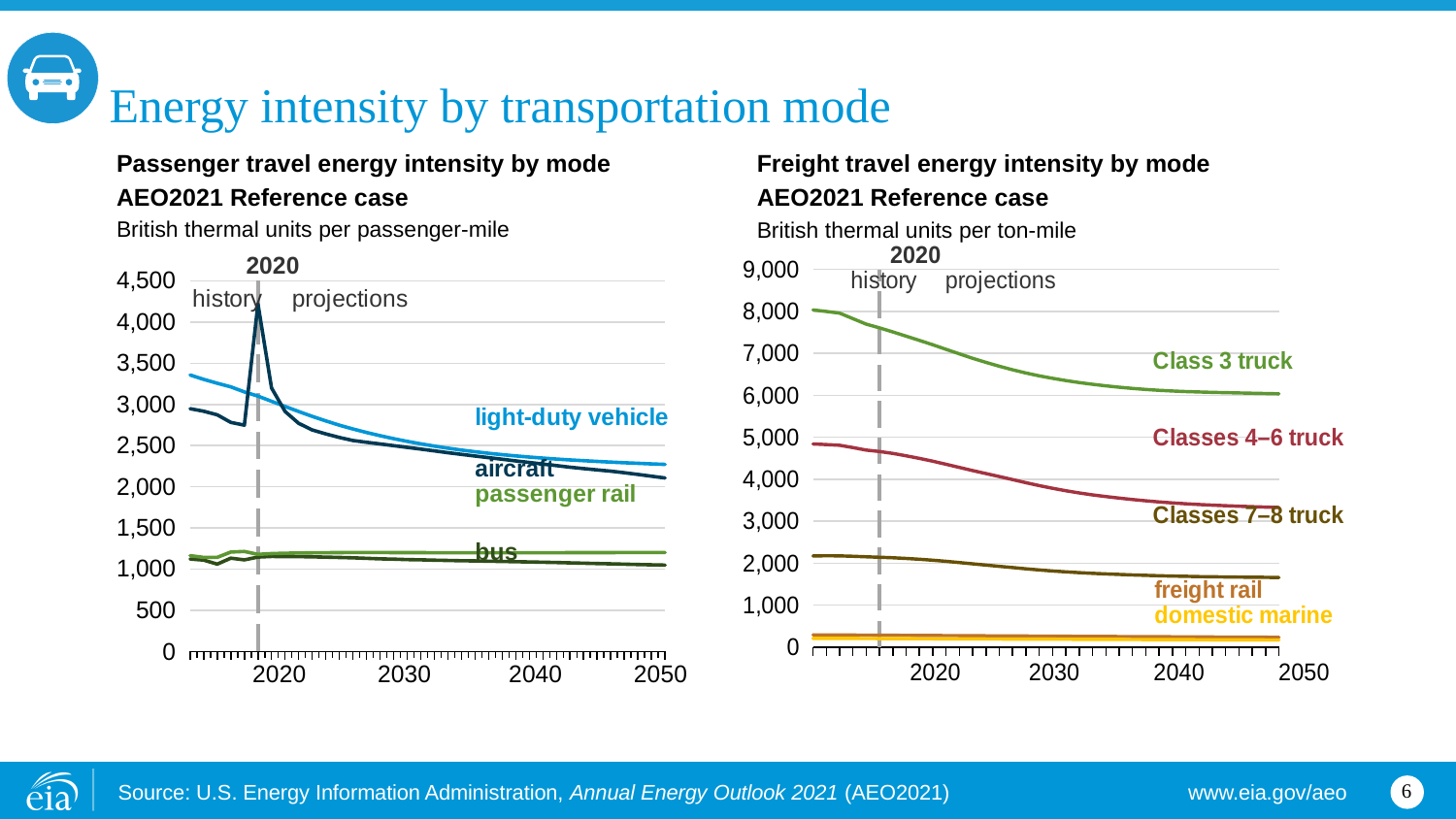
On the Passenger travel energy intensity by mode chart, is the peak value for aircraft greater or less than 4,000? greater On the Freight travel energy intensity by mode chart, does the energy intensity of Class 3 truck rise or fall from 2020 to 2050? fall On the Freight travel energy intensity by mode chart, is the value for Classes 7–8 truck in 2050 greater or less than 1,000? greater How many series are plotted on the Freight travel energy intensity by mode chart? 5 On the Freight travel energy intensity by mode chart, is the value for freight rail in 2050 greater or less than 1,000? less What kind of chart is the Passenger travel energy intensity by mode chart? line chart On the Freight travel energy intensity by mode chart, which mode has the highest energy intensity across the whole period? Class 3 truck What unit is used on the Freight travel energy intensity by mode chart? British thermal units per ton-mile On the Passenger travel energy intensity by mode chart, which mode has the highest energy intensity in 2050? light-duty vehicle How many series are plotted on the Passenger travel energy intensity by mode chart? 4 On the Freight travel energy intensity by mode chart, which is higher in 2050: Class 3 truck or Classes 4–6 truck? Class 3 truck